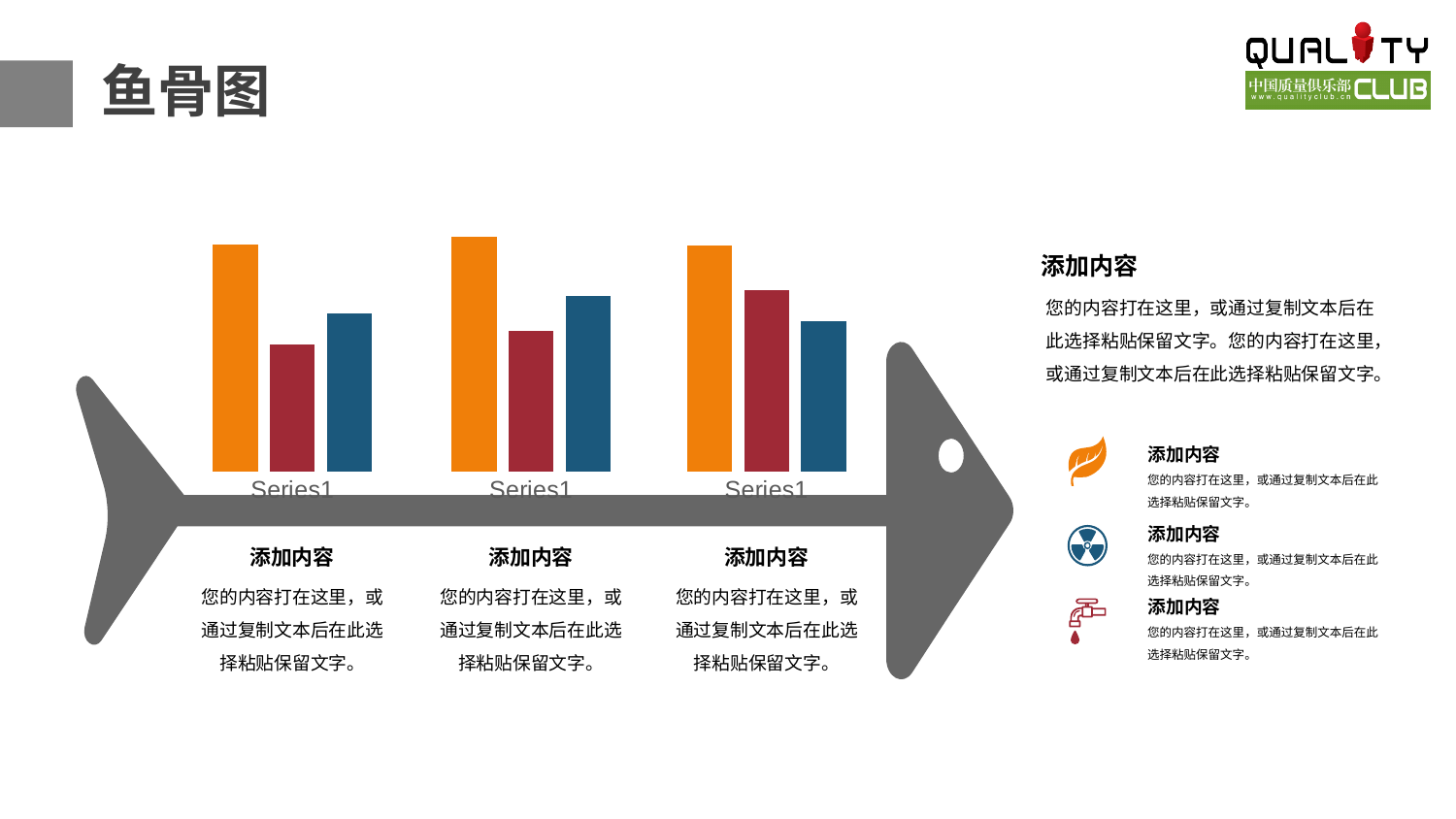
In the left chart, which bar is the tallest? the orange bar In the middle chart, which bar is the tallest? the orange bar In the right chart, which bar is the tallest? the orange bar In the right chart, which is taller, the red bar or the blue bar? the red bar How many bars does the middle chart show? 3 How many bars does the right chart show? 3 In the right chart, which bar is the shortest? the blue bar In the left chart, which bar is the shortest? the red bar What category label is printed beneath the bars of the left chart? Series1 What kind of chart is the left chart on the slide? bar chart How many bars does the left chart show? 3 In the middle chart, which bar is the shortest? the red bar